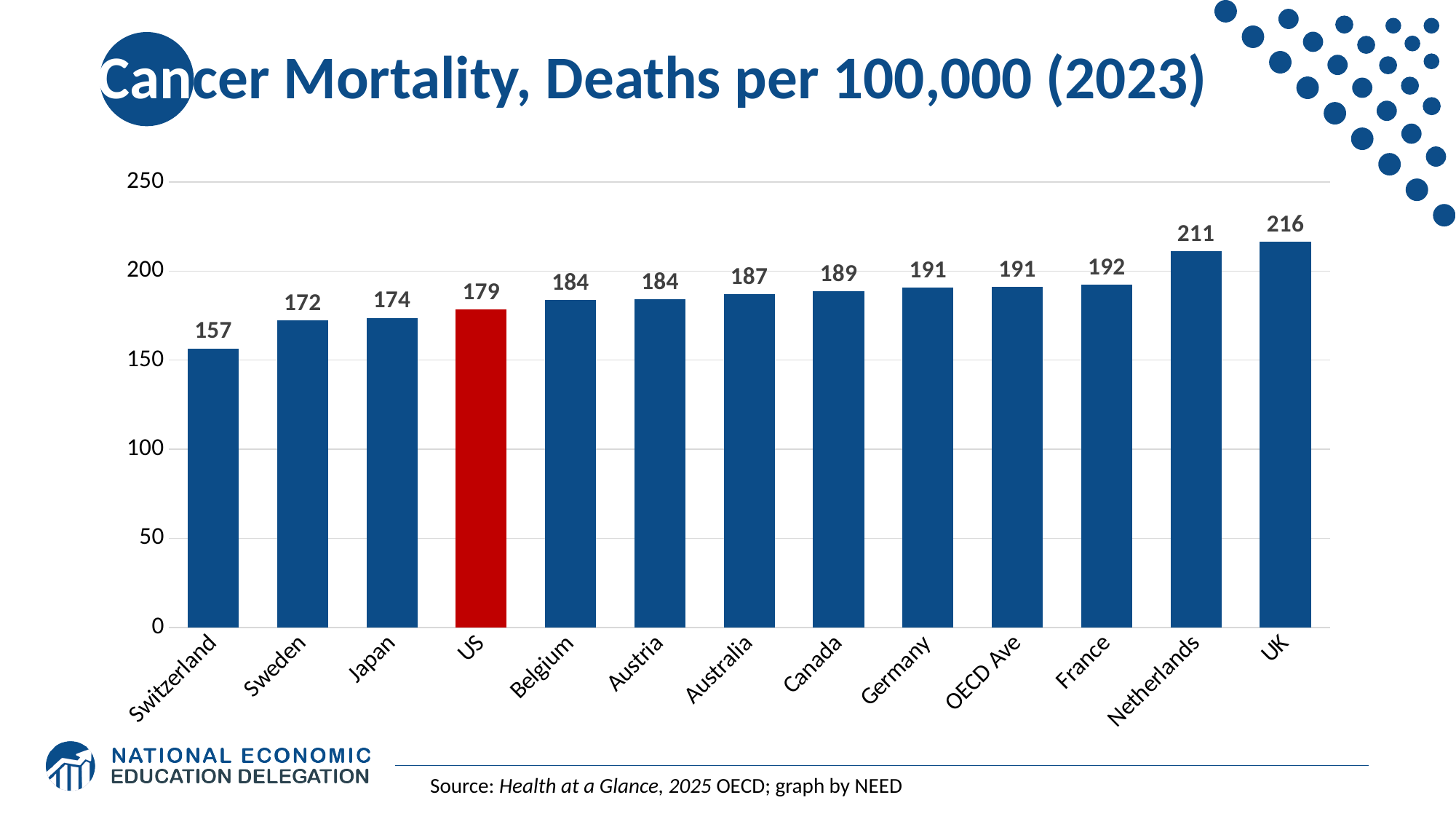
Is the value for France greater or less than 150? greater What kind of chart is shown on the slide? Bar chart How many categories are shown on the x axis? 13 What is the value shown for Switzerland? 157 What is the difference between the UK's value and the US value? 37 What is the cancer mortality rate for the US? 179 What is the value shown for the OECD Ave? 191 Which has a higher cancer mortality rate, Netherlands or Japan? Netherlands Which country has the lowest cancer mortality rate on the chart? Switzerland Which country has the highest cancer mortality rate on the chart? UK Which bar is coloured red instead of blue? US What is the difference between the OECD Ave and Switzerland? 34